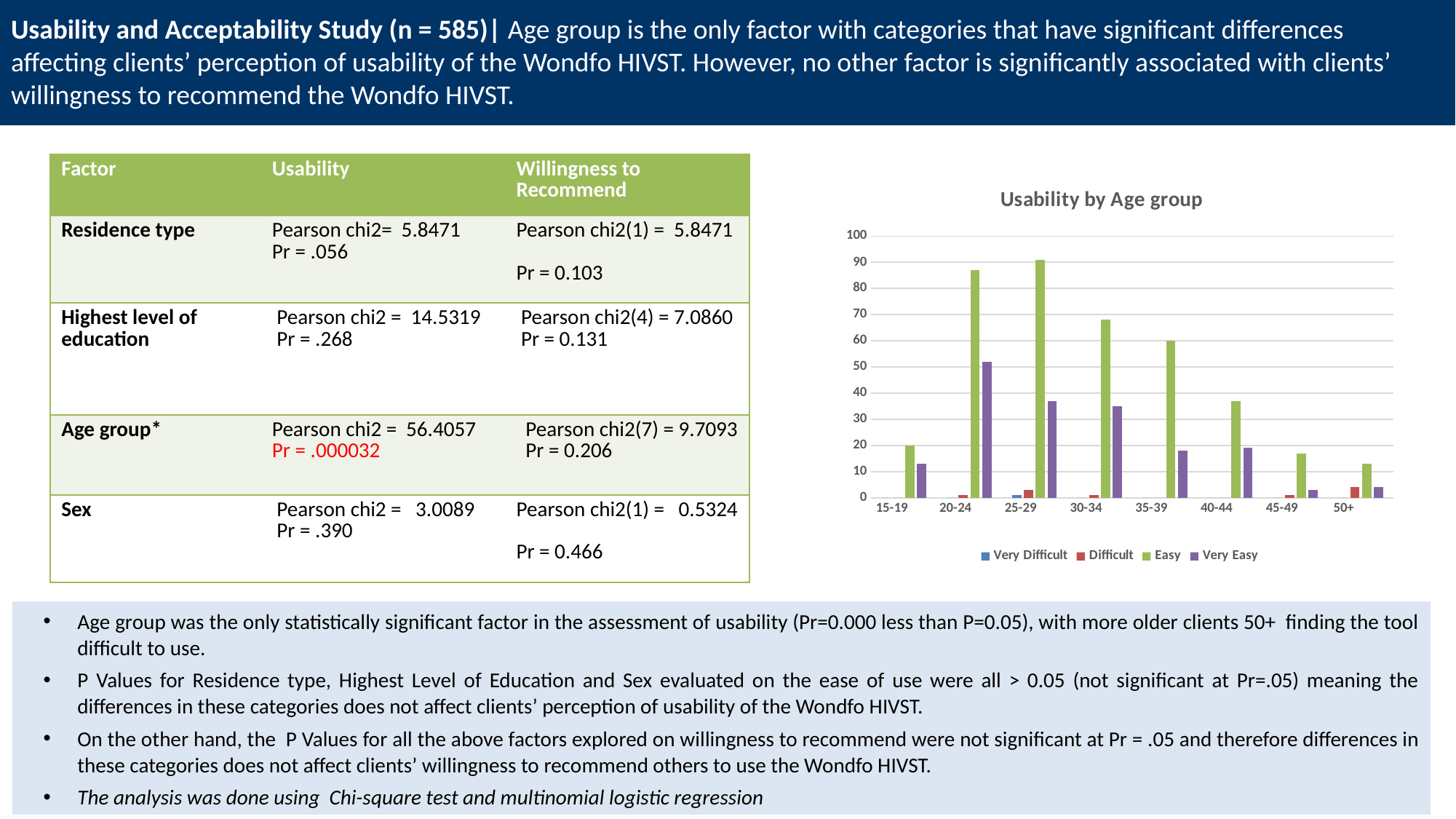
Is the 'Easy' value for the 40-44 age group greater or less than 30? greater Which series is shown in green in the 'Usability by Age group' chart? Easy What type of chart is 'Usability by Age group'? bar chart What is the title of the chart on the slide? Usability by Age group How many series does the legend of the 'Usability by Age group' chart list? 4 In the 'Usability by Age group' chart, which age group has a larger 'Easy' value: 35-39 or 45-49? 35-39 Is the 'Easy' value for the 20-24 age group greater or less than 80? greater Which age group has the highest 'Easy' value in the 'Usability by Age group' chart? 25-29 Is the 'Very Easy' value for the 30-34 age group greater or less than 40? less In the 'Usability by Age group' chart, which is larger for the 30-34 age group: 'Easy' or 'Very Easy'? Easy Which age group has the highest 'Very Easy' value in the 'Usability by Age group' chart? 20-24 How many age group categories are shown on the x axis of the 'Usability by Age group' chart? 8